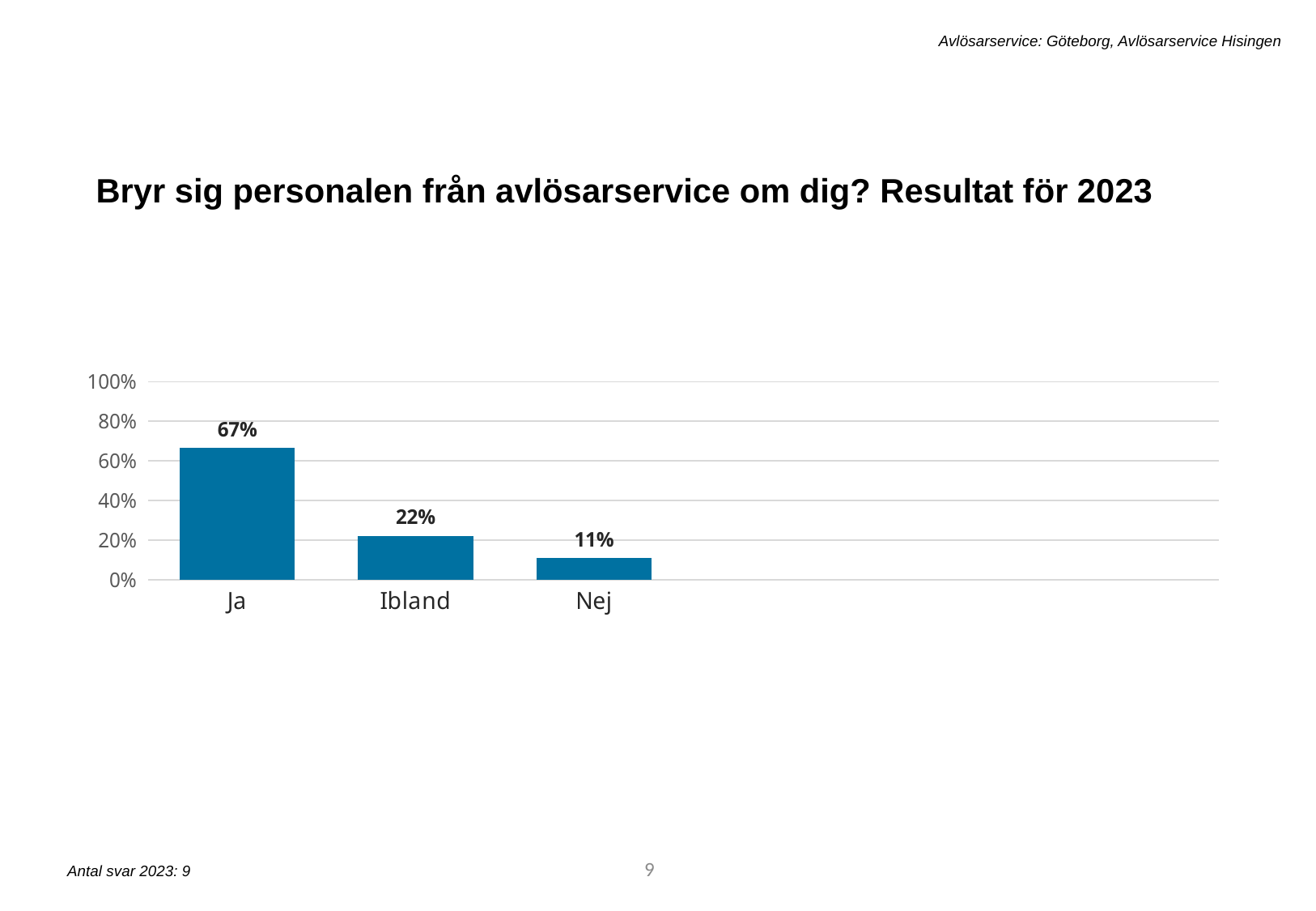
What is the value for Nej? 11% Do the values rise or fall from left to right along the x axis? fall How many categories are shown on the x axis? 3 What is the value for Ibland? 22% What kind of chart is shown on the slide? bar chart Which category has the lowest value? Nej What is the difference between the values for Ibland and Nej? 11% What is the difference between the values for Ja and Ibland? 45% What is the value for Ja? 67% Which category has the highest value? Ja Is the value for Ja greater or less than 60%? greater Which is larger, the value for Ibland or the value for Nej? Ibland